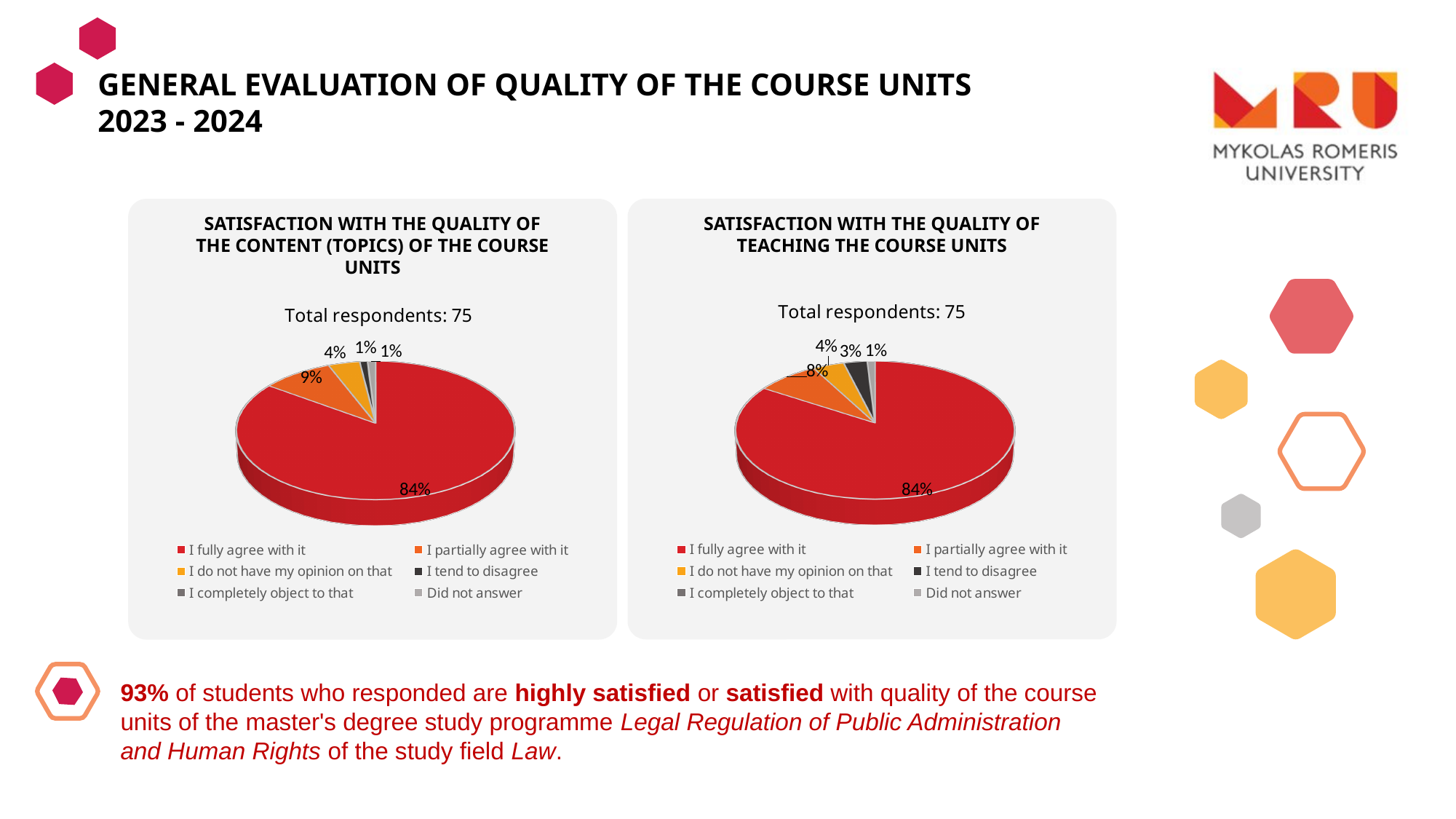
What is the difference between the 'I partially agree with it' share on the left chart and on the right chart? 1% How many response categories does the legend of the right chart (satisfaction with the quality of teaching the course units) list? 6 How many total respondents are reported for the left chart (satisfaction with the quality of the content of the course units)? 75 On the right chart (satisfaction with the quality of teaching the course units), what percentage of respondents do not have an opinion? 4% On the left chart (satisfaction with the quality of the content of the course units), which response category has the largest share? I fully agree with it On the right chart (satisfaction with the quality of teaching the course units), what percentage of respondents tend to disagree? 3% On the right chart (satisfaction with the quality of teaching the course units), which is larger: the share for 'I partially agree with it' or 'I tend to disagree'? I partially agree with it What is the title of the right chart? Satisfaction with the quality of teaching the course units On the left chart (satisfaction with the quality of the content of the course units), what percentage of respondents fully agree? 84% On the right chart (satisfaction with the quality of teaching the course units), what percentage of respondents partially agree? 8% What type of chart is used on the left (satisfaction with the quality of the content of the course units)? Pie chart On the left chart (satisfaction with the quality of the content of the course units), what percentage of respondents partially agree? 9%